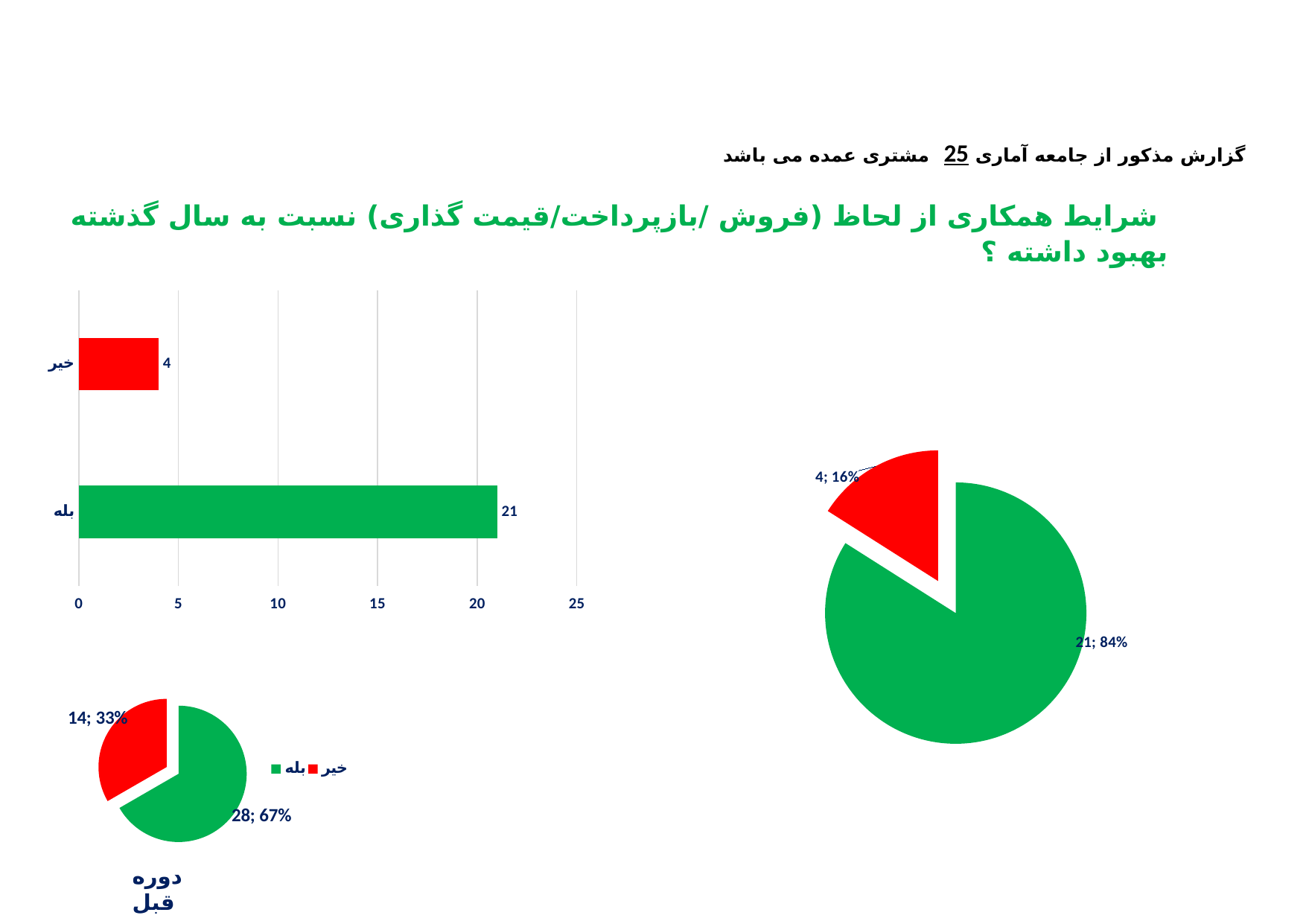
In the bar chart on the left, is the value for بله greater or less than 20? greater How many categories does the bar chart on the left show? 2 In the large pie chart on the right, what is the value shown for the red slice (خیر)? 4 In the bar chart on the left, what is the difference between the values for بله and خیر? 17 In the small pie chart labelled دوره قبل at the bottom left, what is the value shown for the green slice (بله)? 28 How many entries does the legend next to the small pie chart at the bottom left list? 2 What kind of chart is the chart at the top left of the slide? bar chart In the small pie chart labelled دوره قبل at the bottom left, what share does the red slice (خیر) have? 33% In the bar chart on the left, which category has the highest value? بله In the bar chart on the left, what is the value for خیر? 4 In the bar chart on the left, what is the value for بله? 21 In the large pie chart on the right, what share does the green slice (بله) have? 84%